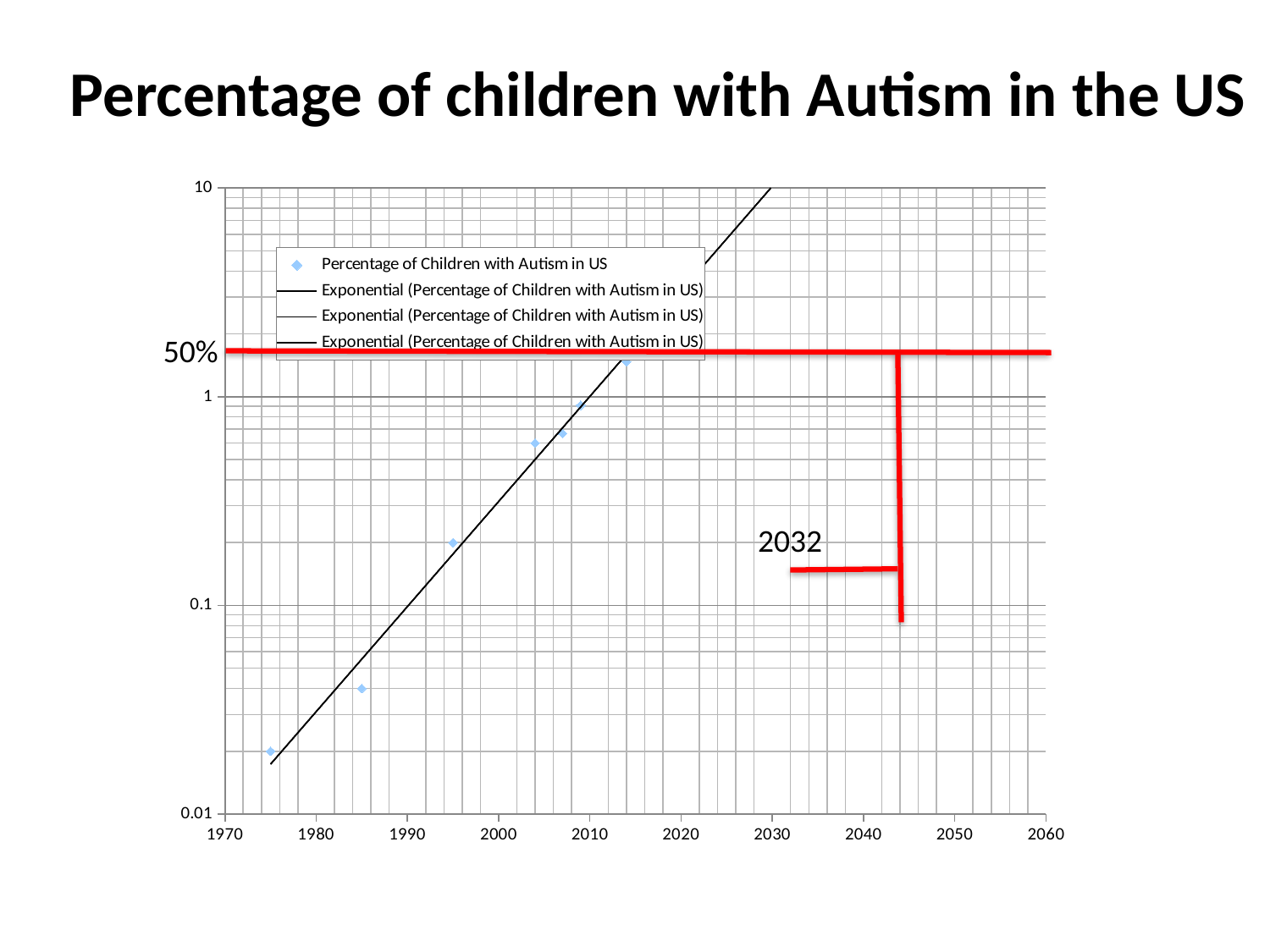
Which year has the lowest plotted percentage of children with autism? 1975 What kind of chart is shown on the slide? scatter chart Which year has the highest plotted percentage of children with autism? 2014 Is the plotted value for 2014 greater or less than 1? greater How many entries does the chart's legend list? 4 Which year has the larger plotted value, 1985 or 2004? 2004 Is the plotted value for 1995 greater or less than 0.1? greater Do the plotted values rise or fall as the years increase along the x axis? rise What year is written next to the red annotation lines on the chart? 2032 Is the plotted value for 1975 greater or less than 0.1? less What is the title of the slide's chart? Percentage of children with Autism in the US How many data points are plotted for Percentage of Children with Autism in US? 7